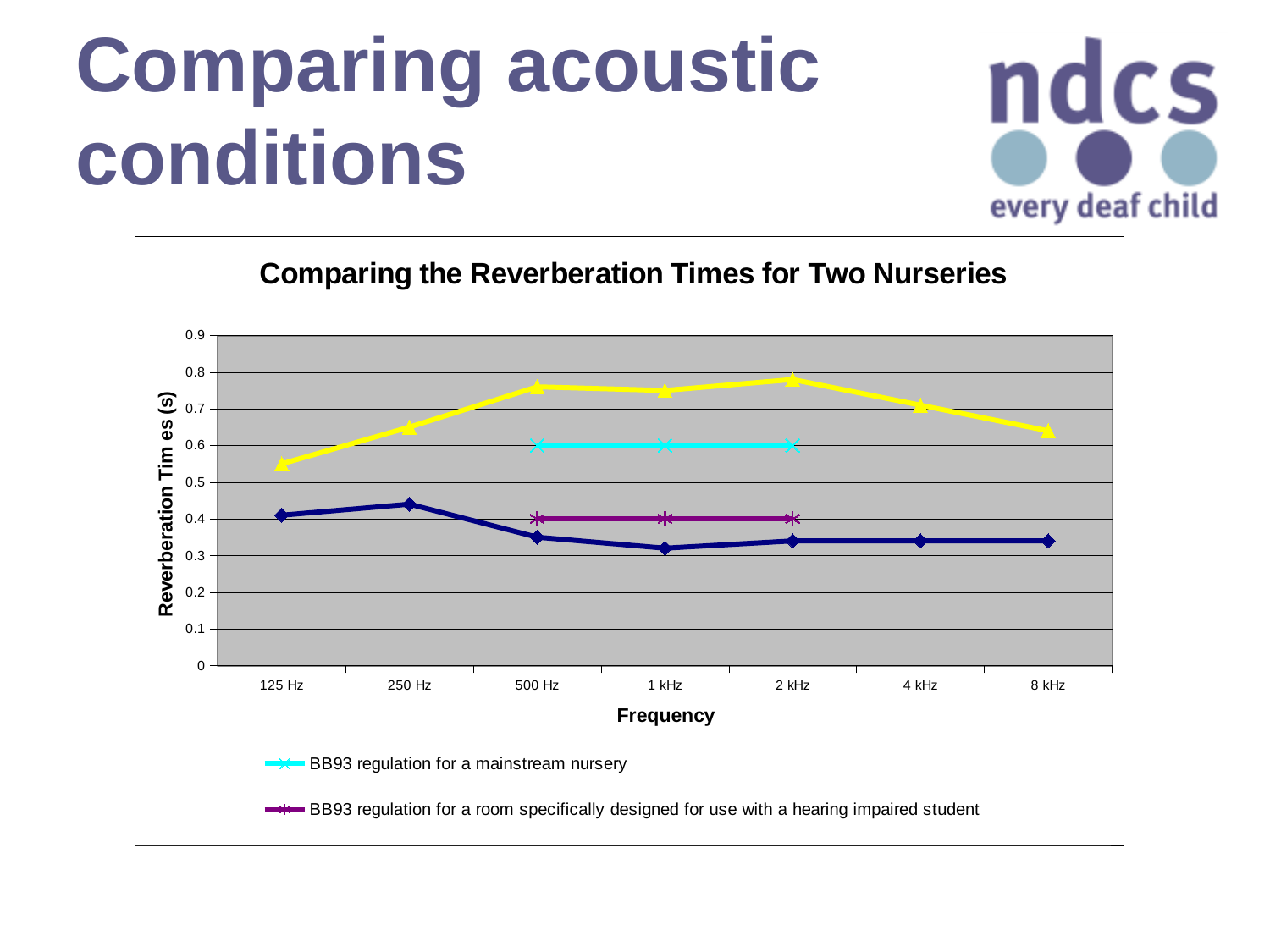
How many series does the legend list? 2 What kind of chart is shown on the slide? Line chart How many frequency categories are shown on the x axis? 7 Does the yellow line rise or fall from 2 kHz to 8 kHz? Fall Is the value of the dark blue line at 1 kHz greater or less than 0.4? less Is the value of the yellow line at 2 kHz greater or less than 0.7? greater What is the difference between the BB93 regulation for a mainstream nursery and the BB93 regulation for a room specifically designed for use with a hearing impaired student at 2 kHz? 0.2 What is the value of the BB93 regulation for a room specifically designed for use with a hearing impaired student line at 500 Hz? 0.4 Which is larger at 1 kHz: the BB93 regulation for a mainstream nursery or the BB93 regulation for a room specifically designed for use with a hearing impaired student? BB93 regulation for a mainstream nursery What is the value of the BB93 regulation for a mainstream nursery line at 1 kHz? 0.6 What is the label of the y axis? Reverberation Times (s) What is the title of the chart? Comparing the Reverberation Times for Two Nurseries